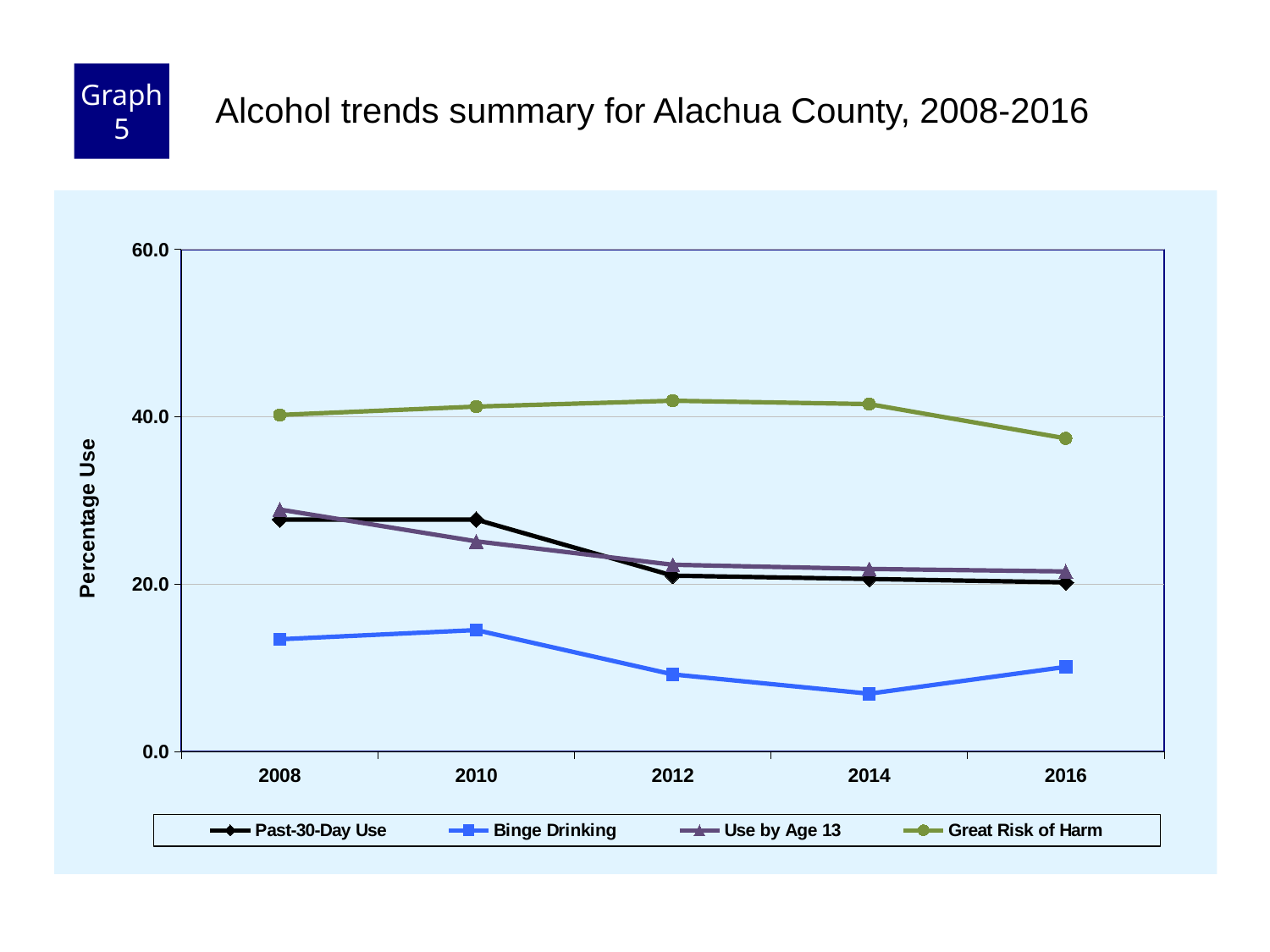
Which series has the lowest values across all years? Binge Drinking Is the value for Great Risk of Harm in 2016 greater or less than 40? less What kind of chart is shown on the slide? line chart Does Great Risk of Harm rise or fall from 2014 to 2016? fall Does Binge Drinking rise or fall from 2010 to 2014? fall Is the value for Past-30-Day Use in 2008 greater or less than 20? greater In 2012, which is larger: Great Risk of Harm or Binge Drinking? Great Risk of Harm What is the label on the y axis? Percentage Use How many years are plotted along the x axis? 5 Is the value for Binge Drinking in 2014 greater or less than 20? less How many series does the legend list? 4 Which series has the highest values across all years? Great Risk of Harm